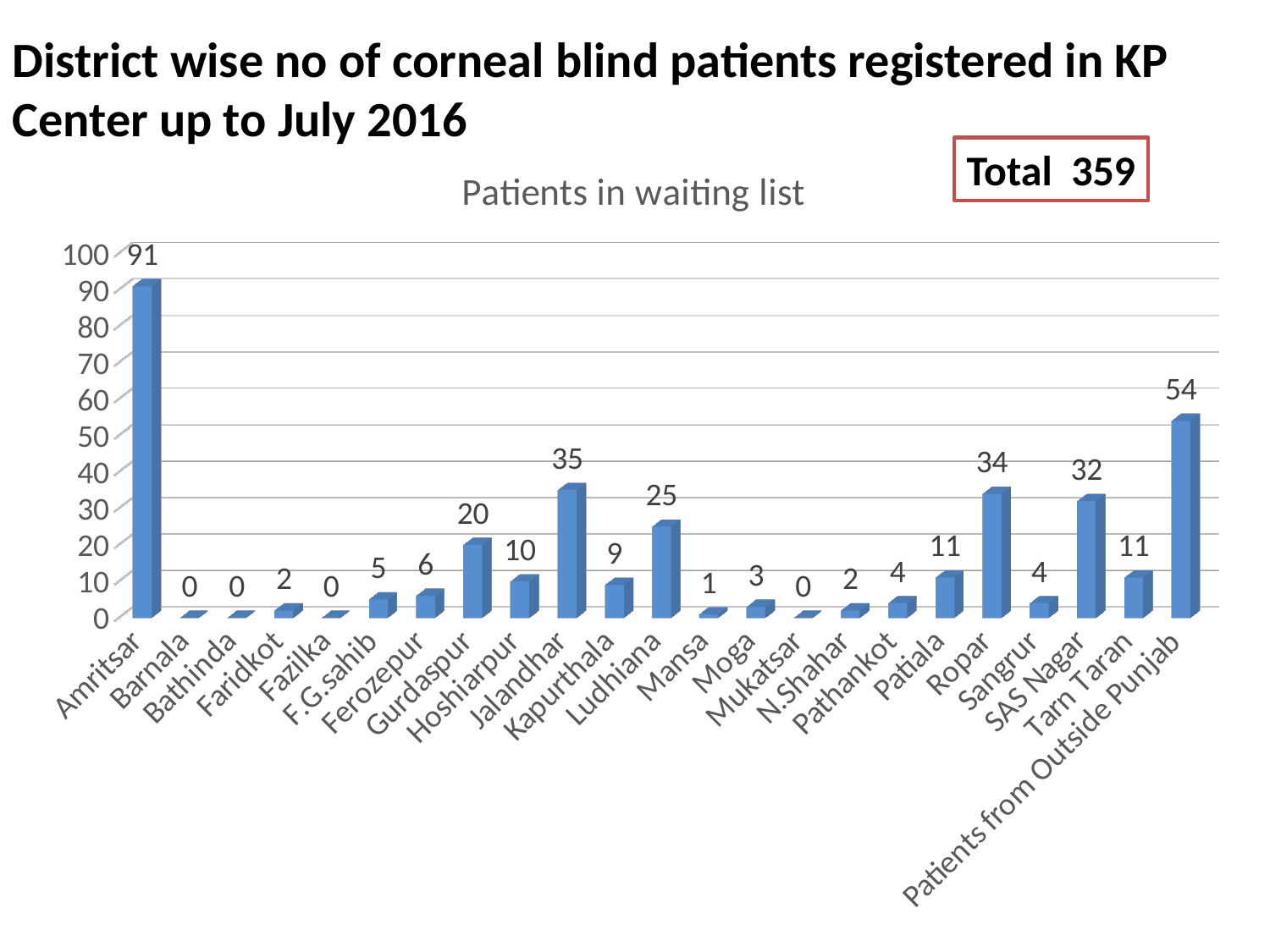
Which is larger, the value for Ludhiana or the value for Hoshiarpur? Ludhiana What is the difference between the values for Amritsar and Patients from Outside Punjab? 37 What is the value for Jalandhar? 35 What kind of chart is shown on the slide? Bar chart How many categories have a value of 0? 4 How many categories are shown on the x axis? 23 What is the difference between the values for Ropar and SAS Nagar? 2 What is the title of the chart? Patients in waiting list What is the value for Gurdaspur? 20 Which category has the highest value? Amritsar What is the value for Amritsar? 91 What is the value for Patients from Outside Punjab? 54